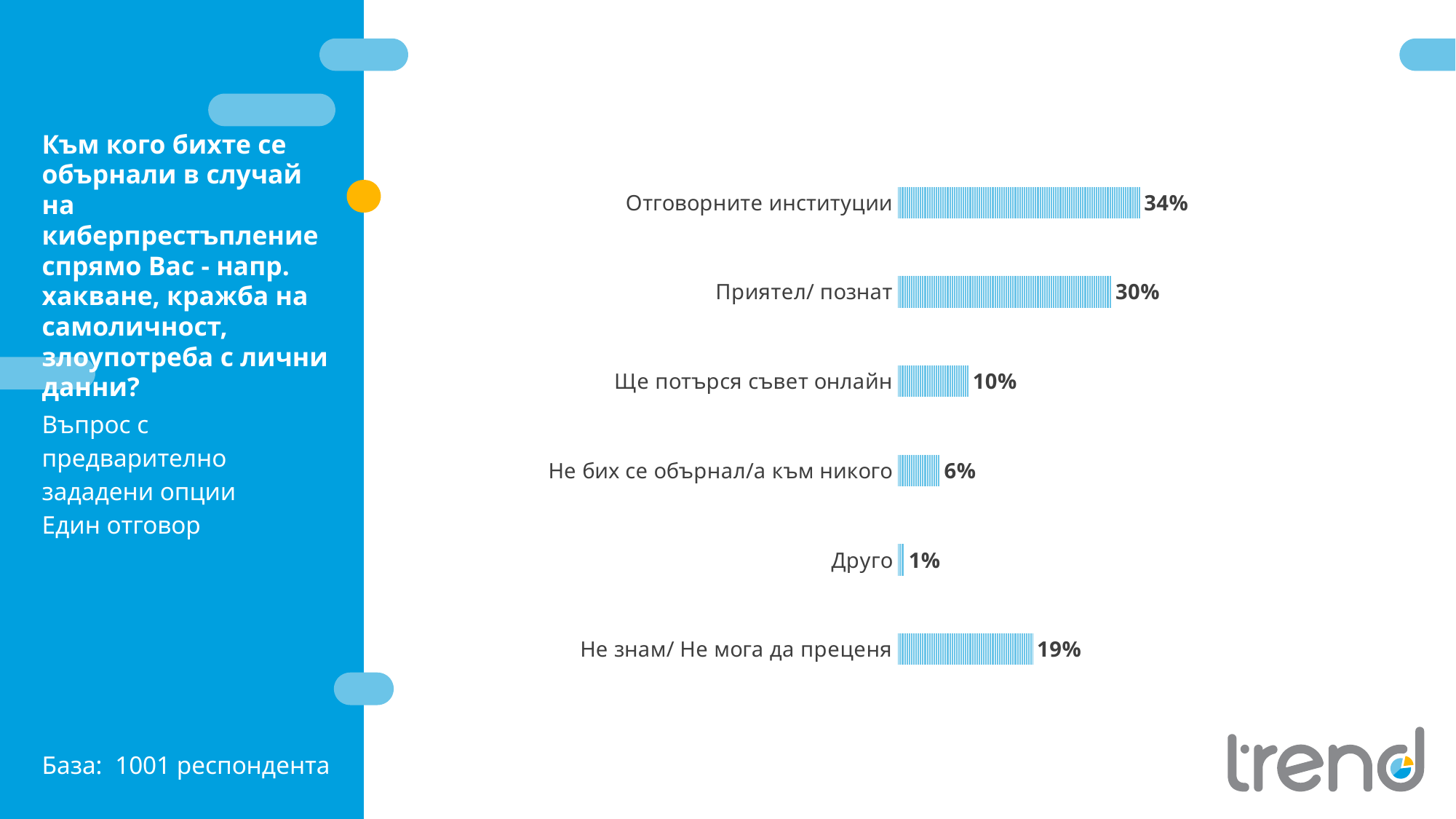
How many categories are shown in the chart? 6 Which category has the highest value? Отговорните институции What is the difference between the values for "Не бих се обърнал/а към никого" and "Друго"? 5% What is the base (number of respondents) stated on the slide? 1001 респондента What is the value for "Ще потърся съвет онлайн"? 10% What is the value for "Не знам/ Не мога да преценя"? 19% Which is larger: the value for "Не знам/ Не мога да преценя" or the value for "Ще потърся съвет онлайн"? Не знам/ Не мога да преценя What is the value for "Отговорните институции"? 34% What kind of chart is shown on the slide? Bar chart What is the value for "Приятел/ познат"? 30% What is the difference between the values for "Отговорните институции" and "Приятел/ познат"? 4% Which category has the lowest value? Друго